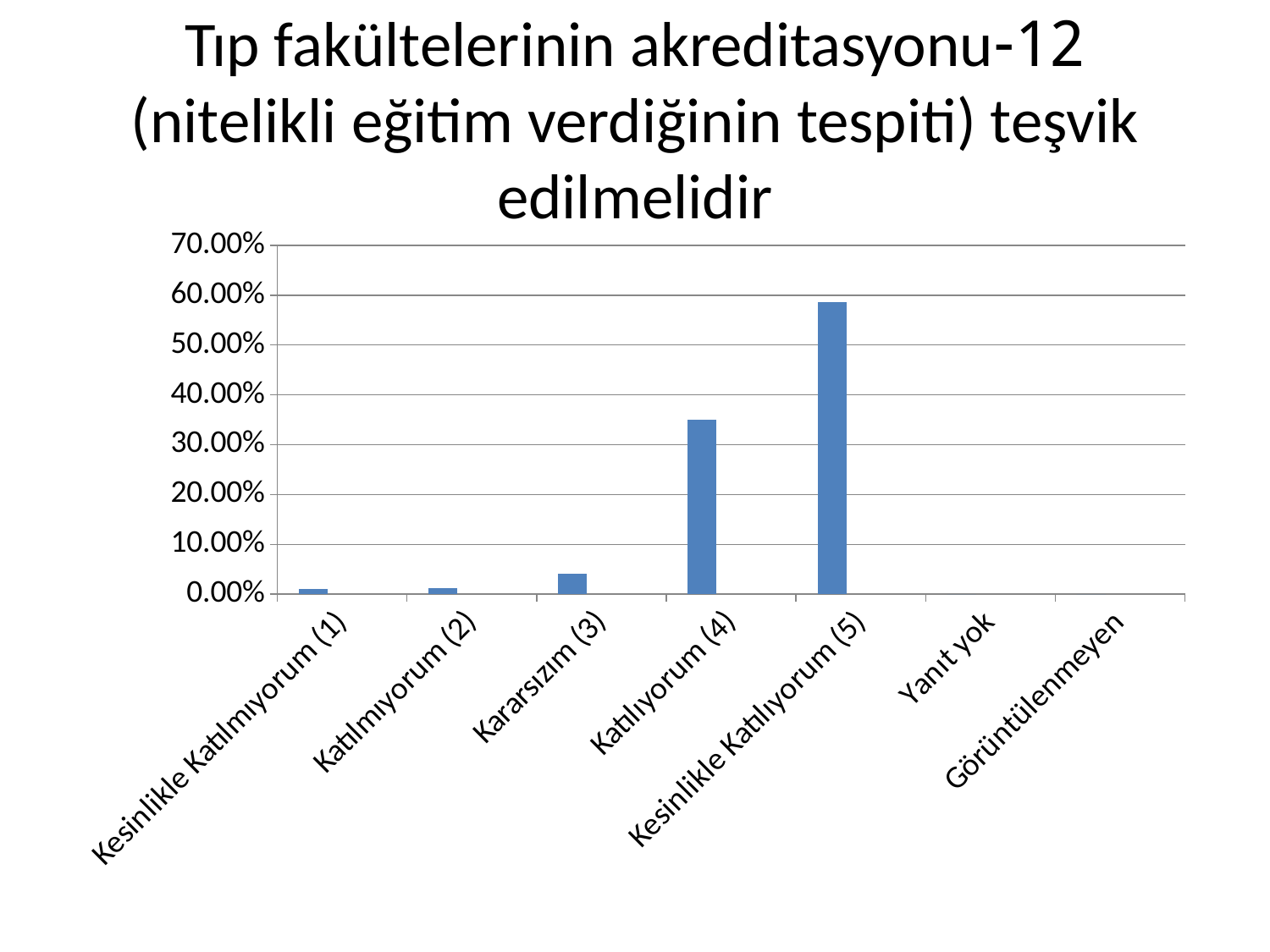
Which is larger, the value for Katılıyorum (4) or the value for Kesinlikle Katılıyorum (5)? Kesinlikle Katılıyorum (5) What is the label of the last category on the x axis? Görüntülenmeyen Is the value for Katılıyorum (4) greater or less than 40.00%? less Which category has the highest value in the chart? Kesinlikle Katılıyorum (5) Is the value for Katılıyorum (4) greater or less than 30.00%? greater Is the value for Kesinlikle Katılıyorum (5) greater or less than 60.00%? less Which is larger, the value for Kararsızım (3) or the value for Katılmıyorum (2)? Kararsızım (3) What is the highest value shown on the y axis of the chart? 70.00% How many categories are shown on the x axis of the chart? 7 What kind of chart is shown on the slide? bar chart